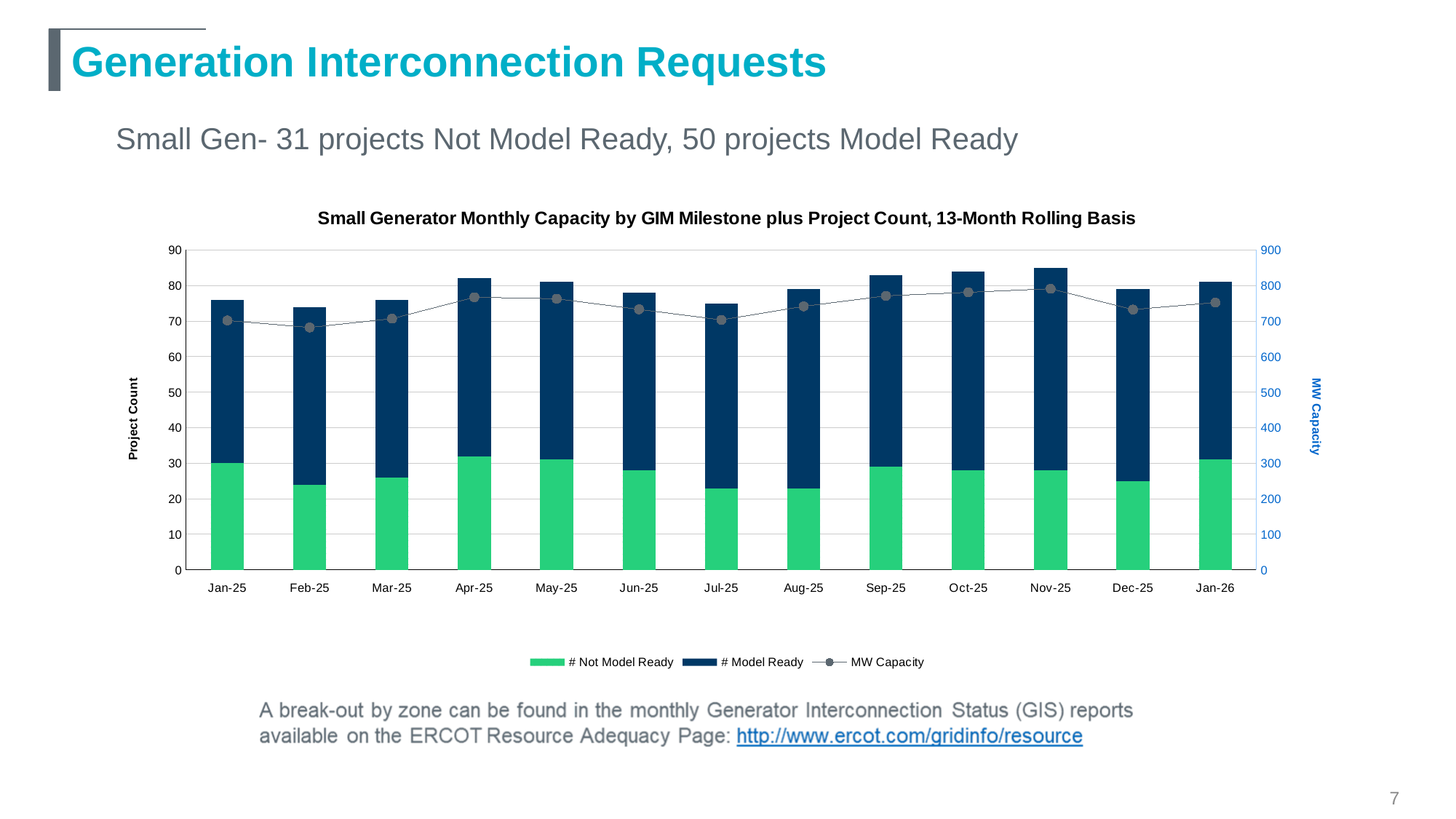
According to the slide, how many Small Gen projects are Not Model Ready in Jan-26? 31 Which month has the larger # Not Model Ready value, Jan-25 or Jul-25? Jan-25 According to the slide, how many Small Gen projects are Model Ready in Jan-26? 50 Is the # Not Model Ready value for Feb-25 greater or less than 30? less How many series does the chart legend list? 3 Which month has the larger total project count, Apr-25 or Feb-25? Apr-25 What is the total project count for the Jan-26 stacked bar (Not Model Ready plus Model Ready)? 81 What kind of chart is shown on the slide? Bar chart with a line How many months are shown on the x axis of the chart? 13 What is the title of the chart? Small Generator Monthly Capacity by GIM Milestone plus Project Count, 13-Month Rolling Basis Is the total project count for Jan-25 greater or less than 70? greater Is the MW Capacity value for Nov-25 greater or less than 700? greater